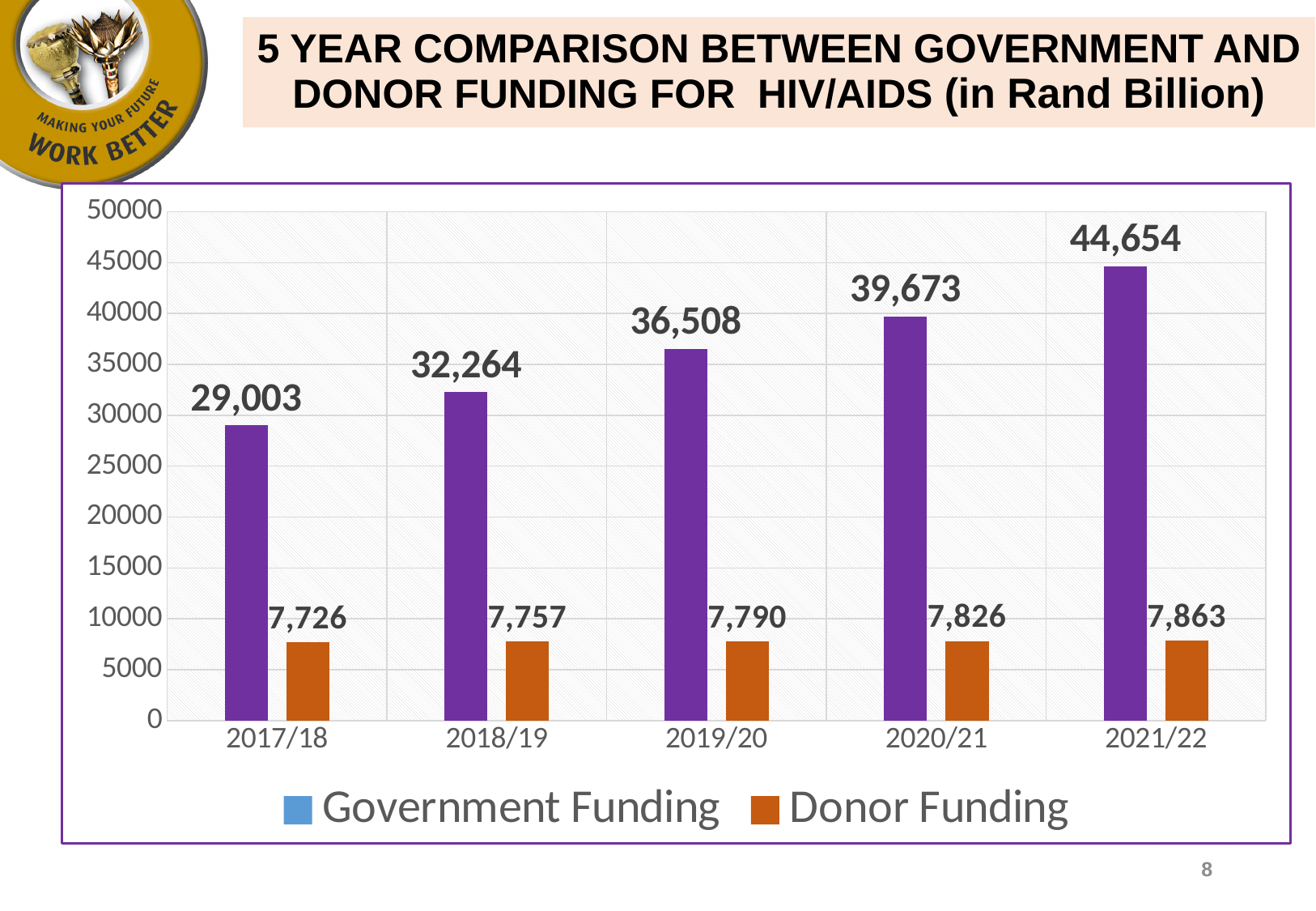
What kind of chart is shown on the slide? Bar chart What is the Government Funding value for 2019/20? 36,508 What is the Donor Funding value for 2017/18? 7,726 How many series does the legend list? 2 How many years are shown on the x axis? 5 Does Government Funding rise or fall from 2017/18 to 2021/22? Rise What is the difference between Government Funding and Donor Funding in 2020/21? 31,847 Which year has the lowest Government Funding? 2017/18 Which year has the highest Government Funding? 2021/22 What is the Donor Funding value for 2021/22? 7,863 By how much did Government Funding increase from 2017/18 to 2021/22? 15,651 Which is larger in 2018/19, Government Funding or Donor Funding? Government Funding